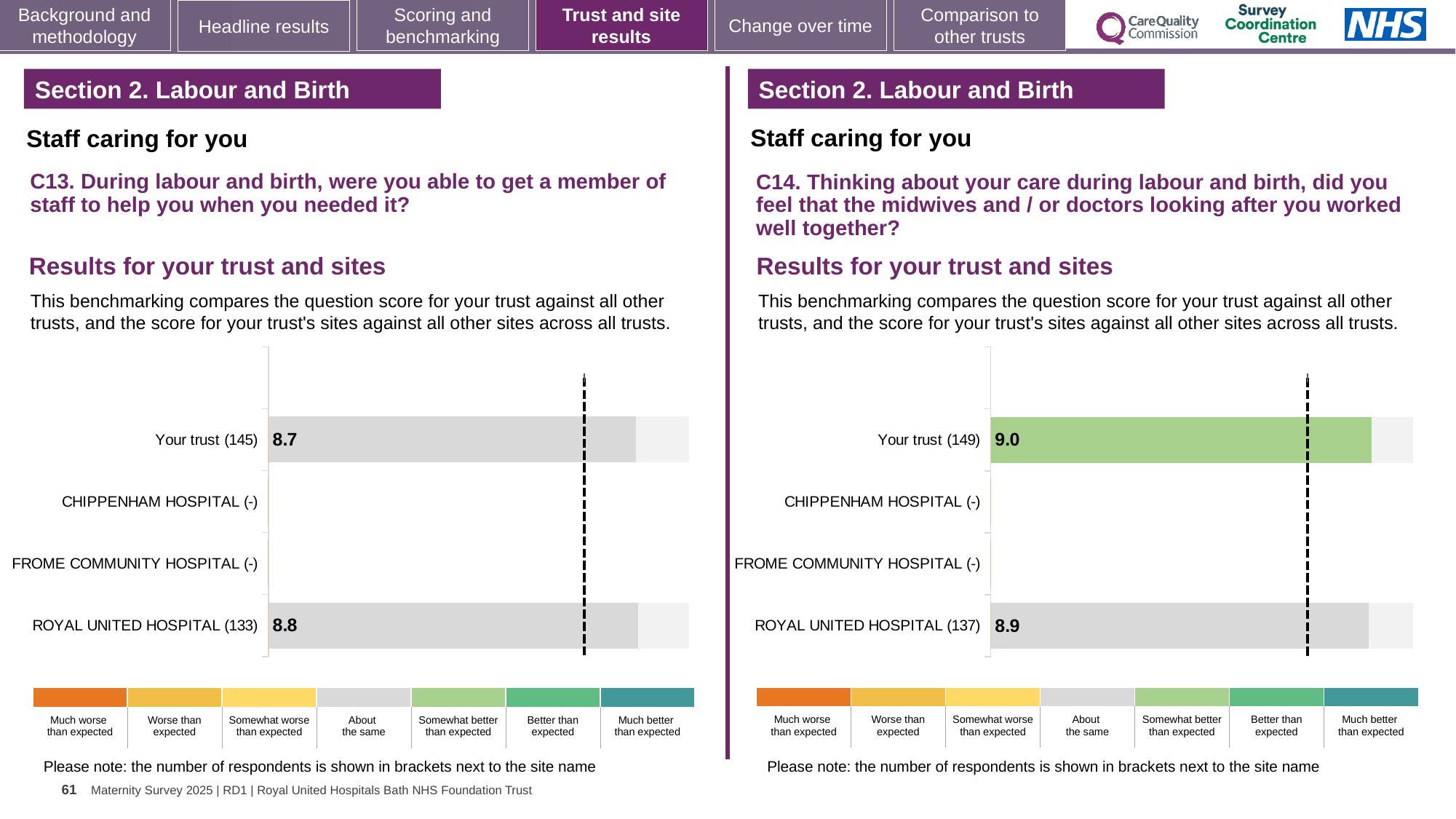
On the C14 chart (right), what is the difference between the Your trust score and the Royal United Hospital score? 0.1 On the C13 chart (left), which has the higher score, Your trust or Royal United Hospital? Royal United Hospital On the C13 chart (left), how many respondents are shown in brackets for Royal United Hospital? 133 On the C14 chart (right), which has the higher score, Your trust or Royal United Hospital? Your trust On the C14 chart (right), what is the score for Royal United Hospital? 8.9 On the C13 chart (left), what is the score for Royal United Hospital? 8.8 How many site/trust categories are listed on the C13 chart (left)? 4 What type of chart is used on the C14 chart (right)? Bar chart On the C13 chart (left), what is the difference between the Royal United Hospital score and the Your trust score? 0.1 On the C14 chart (right), what is the score for Your trust? 9.0 On the C14 chart (right), how many respondents are shown in brackets for Your trust? 149 On the C13 chart (left), what is the score for Your trust? 8.7